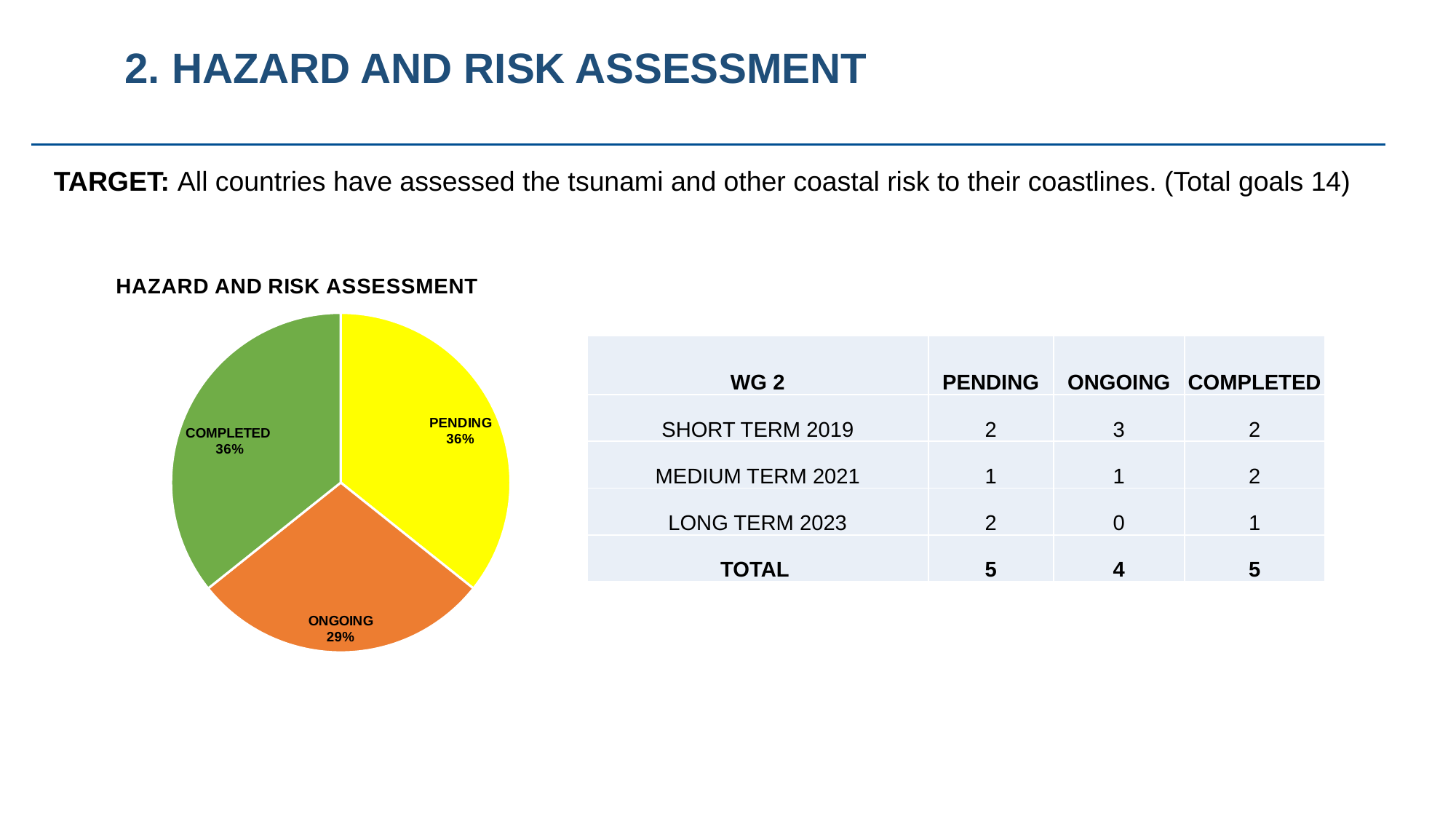
What is the title of the pie chart? HAZARD AND RISK ASSESSMENT Is the share of the ONGOING slice greater or less than 30%? less Which slice of the pie chart is the smallest? ONGOING What is the difference in percentage points between the PENDING and ONGOING slices? 7 What share of the pie does the ONGOING slice represent? 29% What share of the pie does the COMPLETED slice represent? 36% How many slices does the pie chart have? 3 Which is larger, the COMPLETED slice or the ONGOING slice? COMPLETED What share of the pie does the PENDING slice represent? 36% What kind of chart is shown on the slide? pie chart What colour is the ONGOING slice of the pie chart? orange